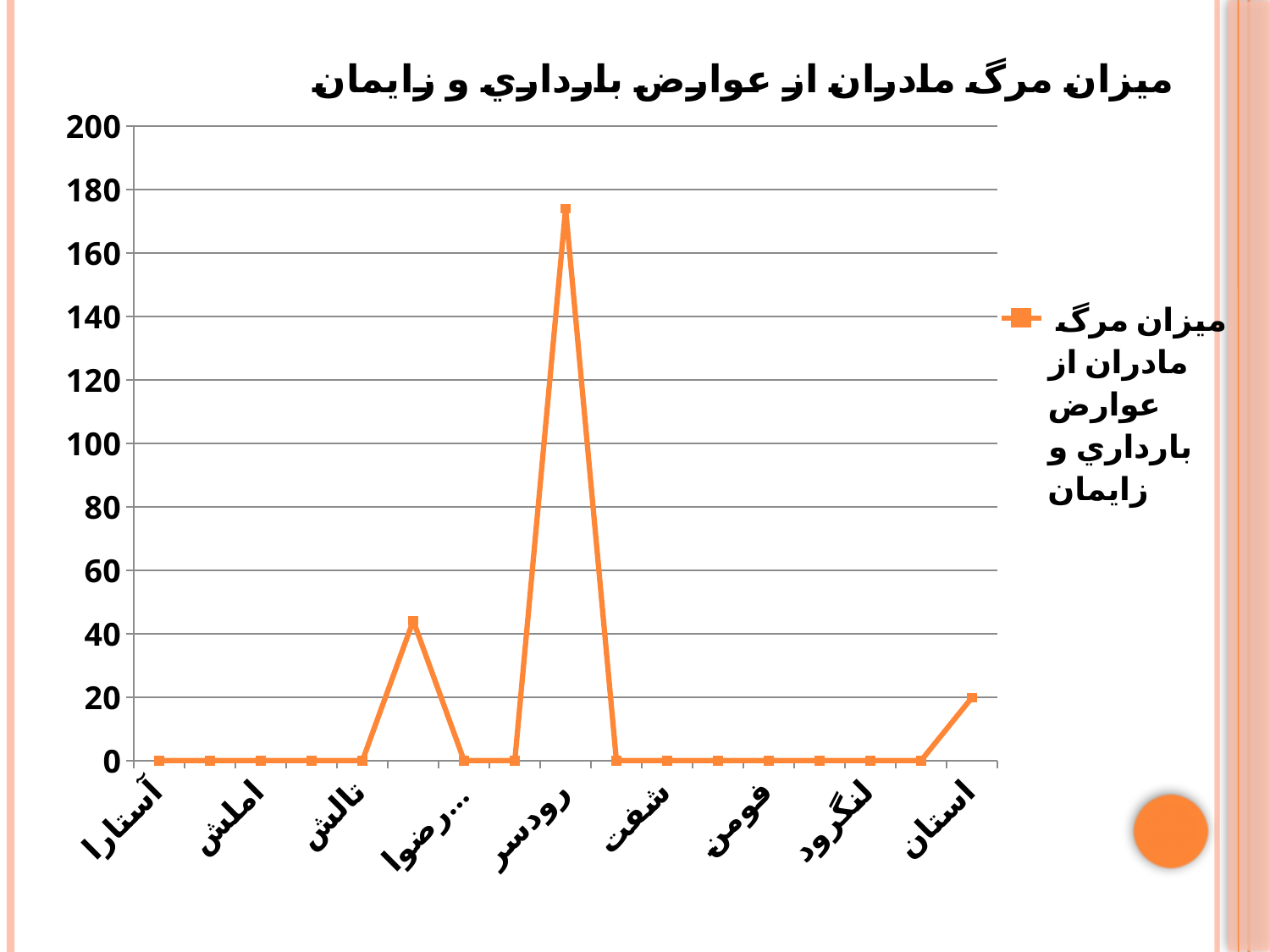
What is the value for آستارا? 0 What is the value for شفت? 0 Is the value for رودسر greater or less than 180? less Is the value for رودسر greater or less than 160? greater How many category labels are shown along the x axis? 9 Which is larger, the value for رودسر or the value for استان? رودسر Which labeled category has the highest value? رودسر What kind of chart is shown on the slide? line chart What is the title of the chart? ميزان مرگ مادران از عوارض بارداري و زايمان How many series does the legend list? 1